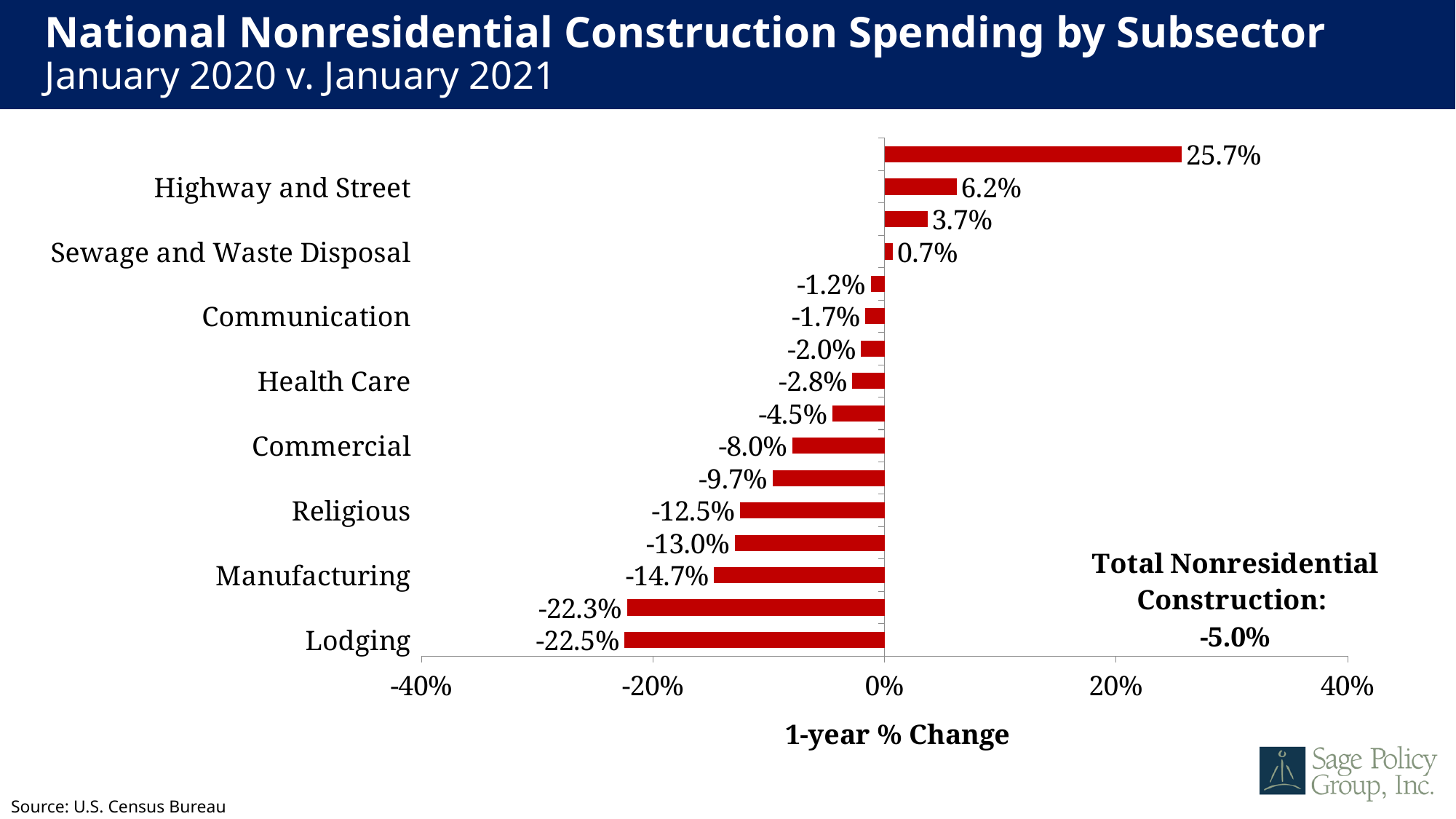
What is the difference between the 1-year % change for Highway and Street and for Sewage and Waste Disposal? 5.5 percentage points What is the lowest 1-year % change value shown on the chart? -22.5% What is the 1-year % change for Manufacturing? -14.7% Which has a larger 1-year % change, Religious or Manufacturing? Religious What is the 1-year % change for Total Nonresidential Construction stated on the slide? -5.0% How many bars are plotted on the chart? 16 Which has a larger 1-year % change, Communication or Health Care? Communication What is the 1-year % change for Highway and Street? 6.2% What is the 1-year % change for Lodging? -22.5% What is the 1-year % change for Commercial? -8.0% What kind of chart is shown on the slide? Bar chart What is the 1-year % change for Sewage and Waste Disposal? 0.7%